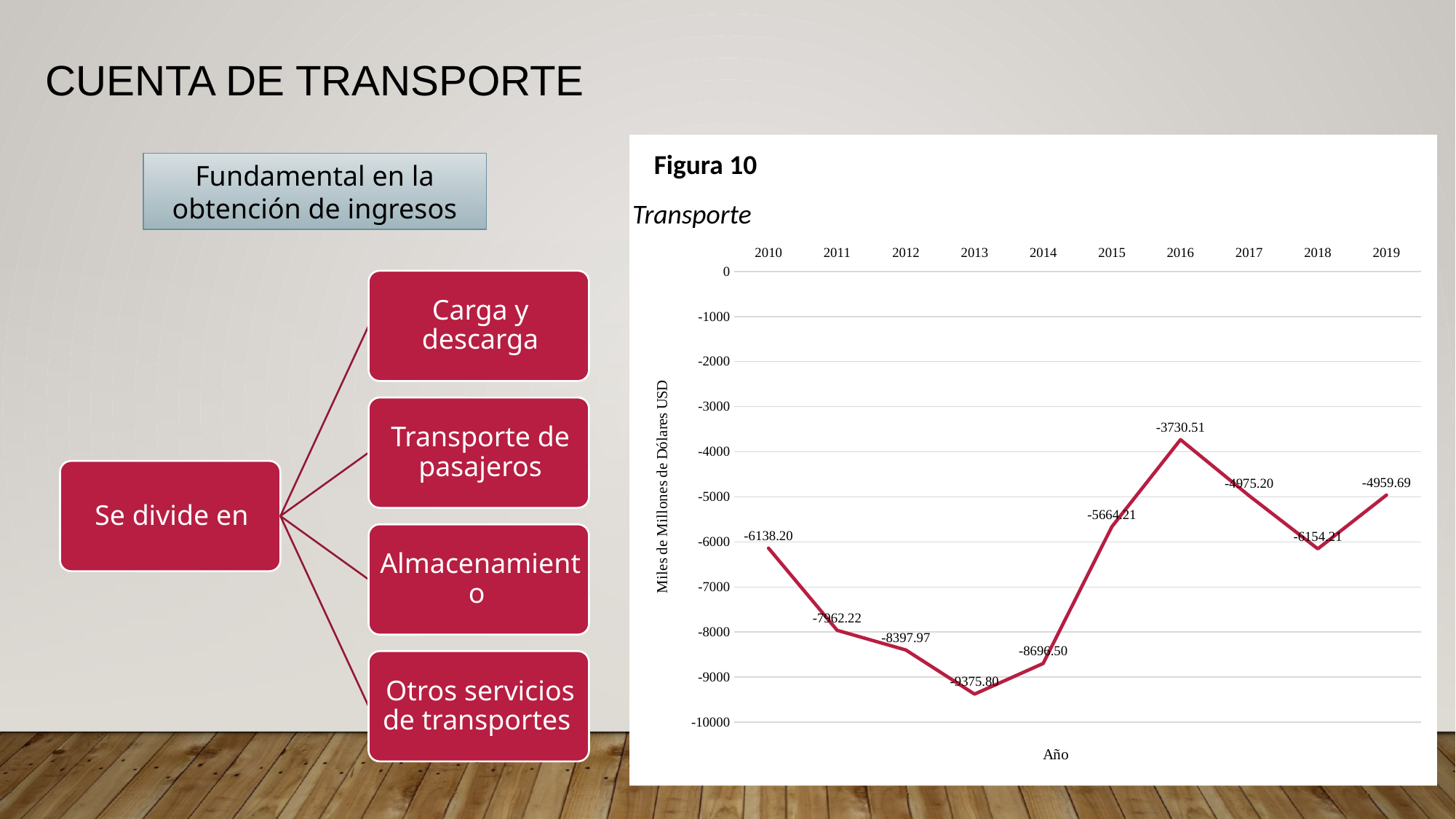
What is the difference between the values for 2016 and 2013 in the Transporte chart? 5645.29 What is the value for 2016 in the Transporte chart? -3730.51 What is the y-axis title of the Transporte chart? Miles de Millones de Dólares USD Which year has the highest value in the Transporte chart? 2016 Between 2013 and 2016, do the values in the Transporte chart rise or fall? rise What is the value for 2010 in the Transporte chart? -6138.20 What is the value for 2019 in the Transporte chart? -4959.69 How many years are plotted in the Transporte chart? 10 Which year has the lowest value in the Transporte chart? 2013 What is the value for 2013 in the Transporte chart? -9375.80 Which year has the larger value in the Transporte chart, 2015 or 2018? 2015 What type of chart is shown in Figura 10? line chart